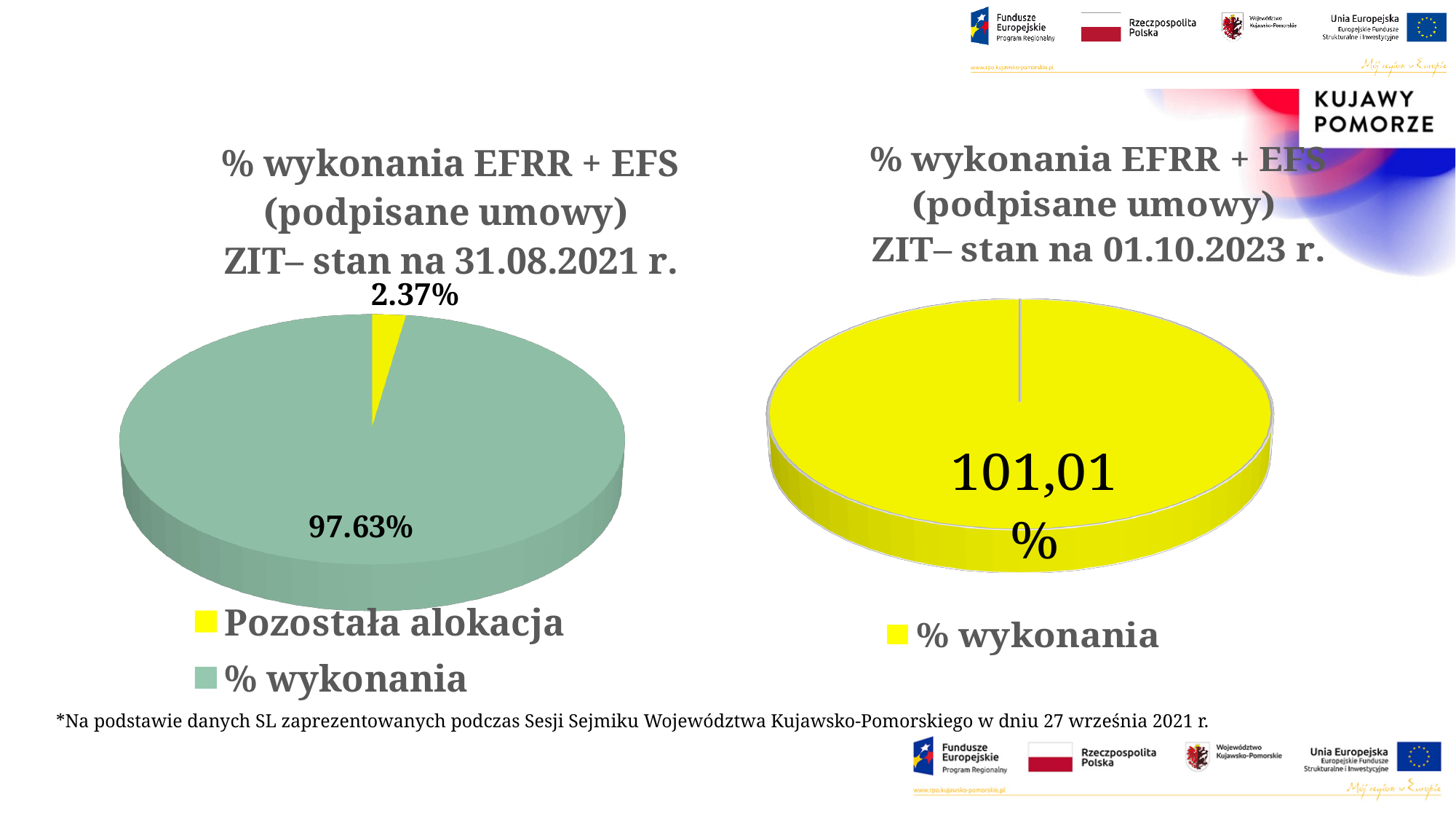
In the left chart (ZIT – stan na 31.08.2021 r.), which category has the largest slice? % wykonania In the left chart (ZIT – stan na 31.08.2021 r.), which category has the smallest slice? Pozostała alokacja In the left chart (ZIT – stan na 31.08.2021 r.), what is the difference between "% wykonania" and "Pozostała alokacja"? 95.26% What type of chart is the left chart (ZIT – stan na 31.08.2021 r.)? Pie chart How many categories does the legend of the right chart (ZIT – stan na 01.10.2023 r.) list? 1 How many categories does the legend of the left chart (ZIT – stan na 31.08.2021 r.) list? 2 In the left chart (ZIT – stan na 31.08.2021 r.), which is larger: "Pozostała alokacja" or "% wykonania"? % wykonania In the left chart (ZIT – stan na 31.08.2021 r.), what is the value for "% wykonania"? 97.63% In the right chart (ZIT – stan na 01.10.2023 r.), what value is shown for "% wykonania"? 101,01% In the left chart (ZIT – stan na 31.08.2021 r.), what colour is the "Pozostała alokacja" slice? Yellow In the left chart (ZIT – stan na 31.08.2021 r.), what is the value for "Pozostała alokacja"? 2.37% What type of chart is the right chart (ZIT – stan na 01.10.2023 r.)? Pie chart